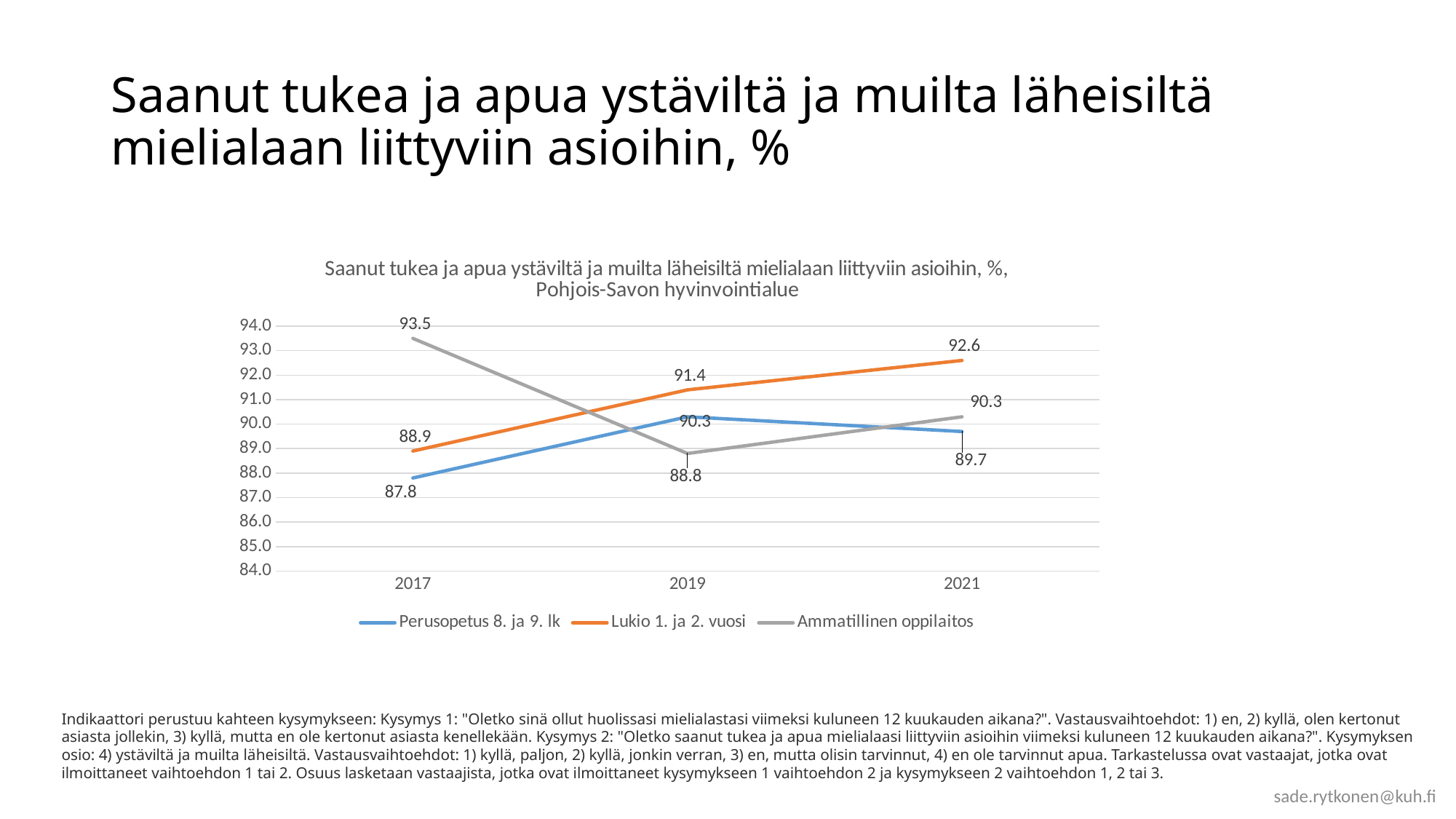
What is the value for Ammatillinen oppilaitos in 2019? 88.8 Which is larger in 2021: the value for Lukio 1. ja 2. vuosi or the value for Perusopetus 8. ja 9. lk? Lukio 1. ja 2. vuosi What is the value for Lukio 1. ja 2. vuosi in 2021? 92.6 How many years are shown on the x axis? 3 What is the value for Perusopetus 8. ja 9. lk in 2017? 87.8 Does the value for Lukio 1. ja 2. vuosi rise or fall from 2017 to 2021? Rise What is the value for Lukio 1. ja 2. vuosi in 2017? 88.9 What is the difference between the Lukio 1. ja 2. vuosi value in 2021 and its value in 2017? 3.7 Which series has the lowest value in 2019? Ammatillinen oppilaitos What kind of chart is shown on the slide? Line chart How many series does the legend list? 3 Which series has the highest value in 2017? Ammatillinen oppilaitos